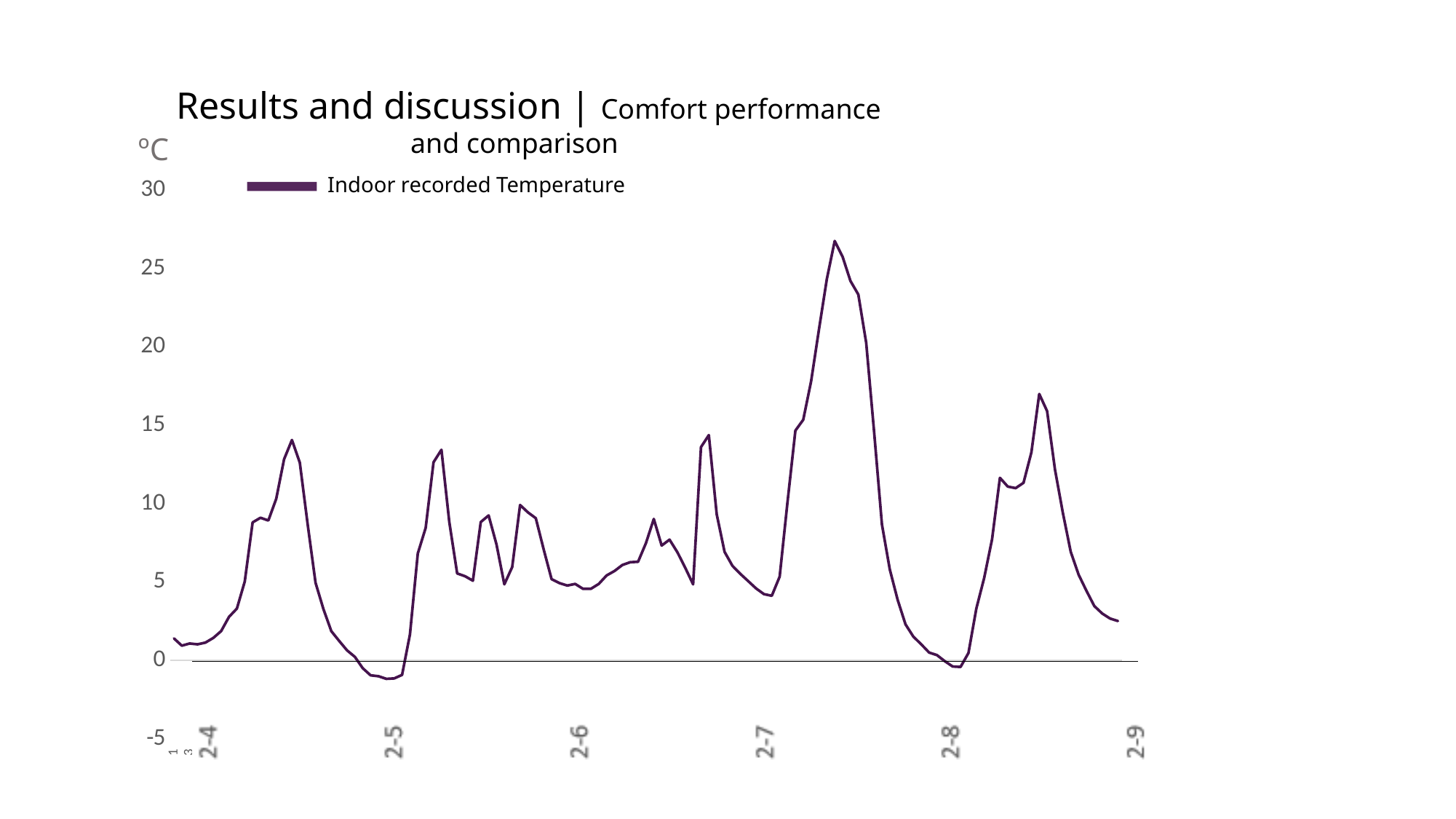
What unit is shown on the vertical axis? °C Is the value at 2-7 greater or less than 10? less Is the highest value reached between 2-8 and 2-9 greater or less than 15? greater Is the highest value reached between 2-7 and 2-8 greater or less than 25? greater How many series does the legend list? 1 What is the name of the series shown in the legend? Indoor recorded Temperature Between which two x-axis labels does the line reach its highest value? between 2-7 and 2-8 What kind of chart is shown on the slide? line chart How many date labels are shown on the x axis? 6 Which is higher: the peak between 2-7 and 2-8, or the peak between 2-8 and 2-9? the peak between 2-7 and 2-8